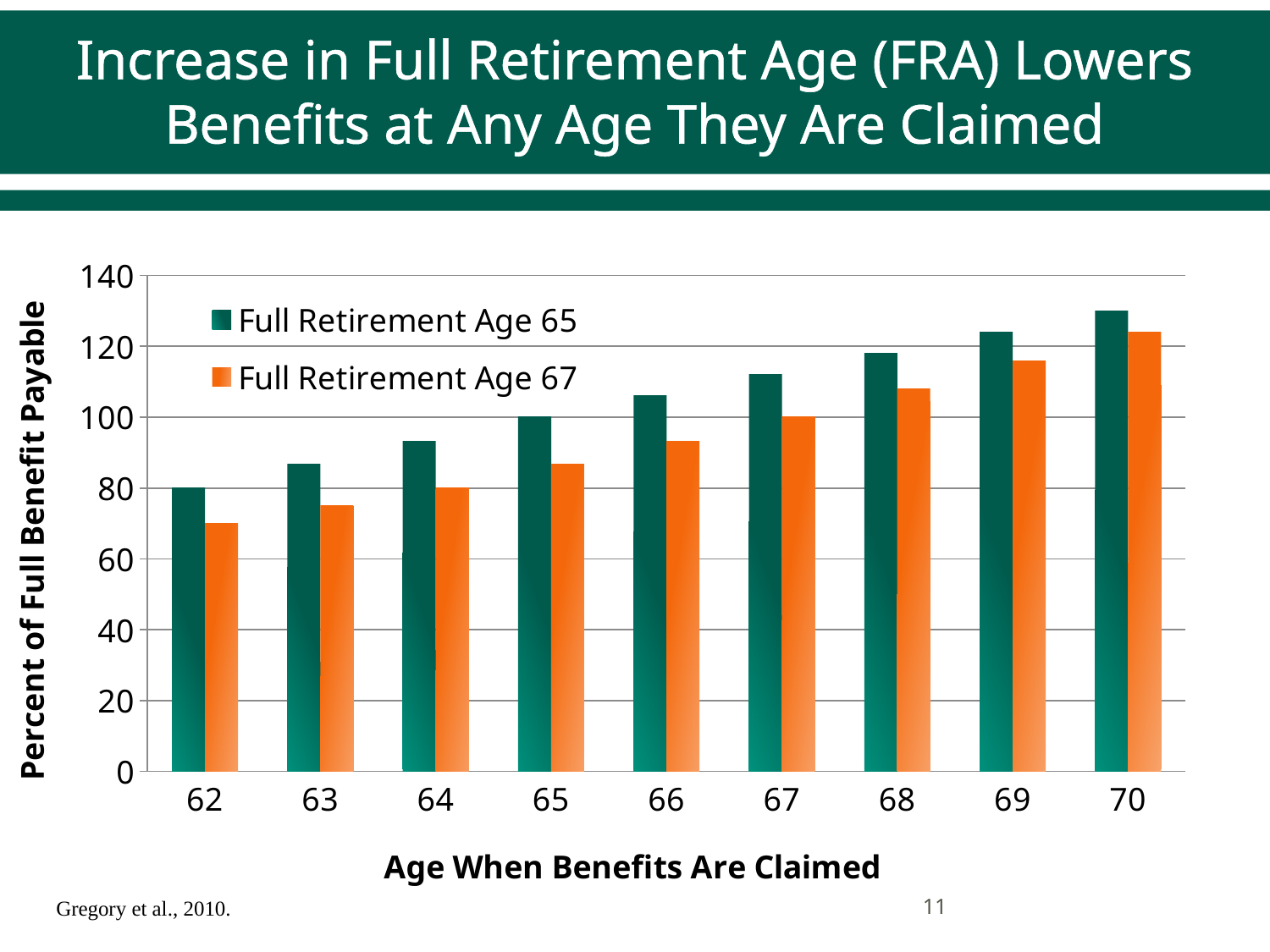
Is the value for Full Retirement Age 65 at age 70 greater or less than 120? greater What is the value for Full Retirement Age 67 at age 64? 80 Do the values for Full Retirement Age 65 rise or fall as the claiming age increases? rise Is the value for Full Retirement Age 67 at age 62 greater or less than 80? less At which claiming age is the Full Retirement Age 65 value lowest? 62 How many claiming ages are shown on the x axis? 9 What is the value for Full Retirement Age 65 at age 65? 100 What is the value for Full Retirement Age 65 at age 62? 80 What kind of chart is shown on the slide? bar chart How many series does the legend list? 2 What is the value for Full Retirement Age 67 at age 67? 100 At which claiming age is the Full Retirement Age 67 value highest? 70